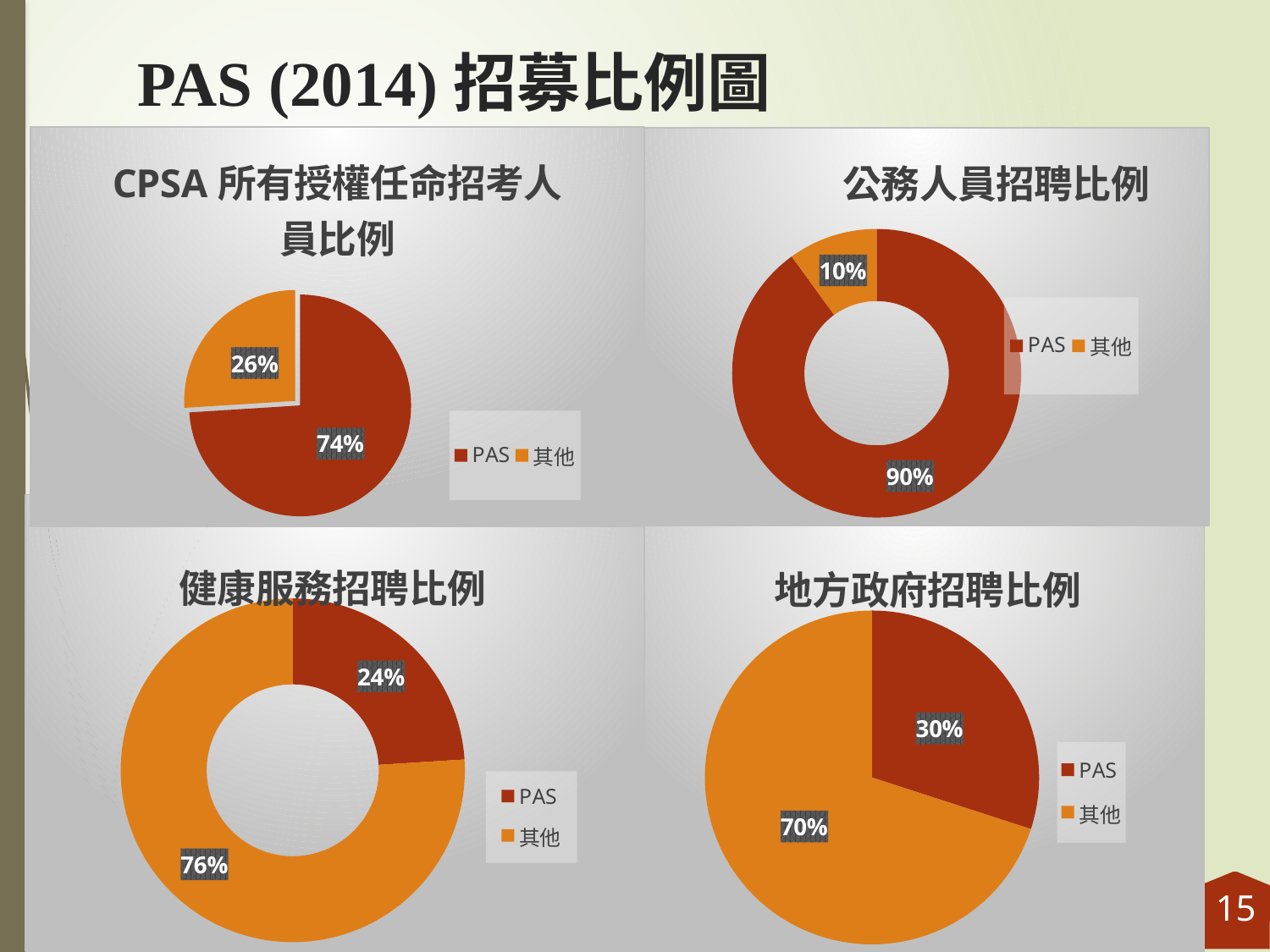
In the chart titled 公務人員招聘比例, what is the value for PAS? 90% What kind of chart is the chart titled 地方政府招聘比例? Pie chart In the chart titled CPSA 所有授權任命招考人員比例, which is larger, PAS or 其他? PAS In the chart titled 健康服務招聘比例, what is the value for PAS? 24% How many charts are shown on the slide? 4 In the chart titled 地方政府招聘比例, what is the difference between the 其他 share and the PAS share? 40% In the chart titled 地方政府招聘比例, what is the value for 其他? 70% In the chart titled CPSA 所有授權任命招考人員比例, what is the value for 其他? 26% In the chart titled 公務人員招聘比例, what colour represents PAS? Dark red In the chart titled 健康服務招聘比例, which category has the largest share? 其他 In the chart titled 公務人員招聘比例, which category has the smallest share? 其他 How many series does the legend of the chart titled 健康服務招聘比例 list? 2